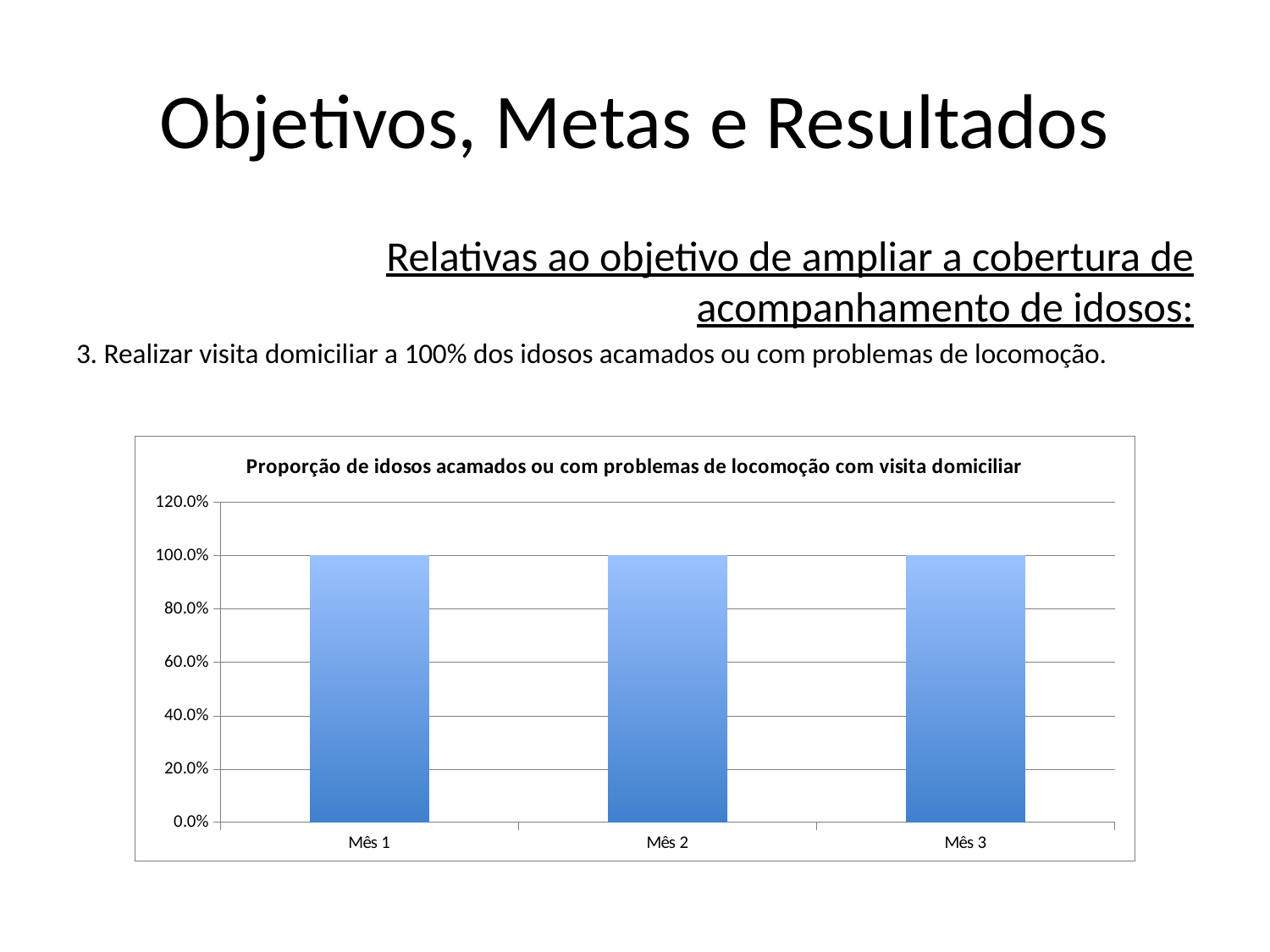
How many categories (months) are shown on the x axis of the chart? 3 What is the value for Mês 2 in the chart? 100.0% What is the title of the chart? Proporção de idosos acamados ou com problemas de locomoção com visita domiciliar Is the value for Mês 3 greater or less than 120.0%? less Is the value for Mês 2 greater or less than 60.0%? greater What is the value for Mês 1 in the chart? 100.0% What is the highest value shown on the y axis of the chart? 120.0% What is the value for Mês 3 in the chart? 100.0% Do the values rise, fall, or stay flat from Mês 1 to Mês 3? stay flat What is the difference between the values for Mês 1 and Mês 3? 0.0% Is the value for Mês 1 greater or less than 80.0%? greater What kind of chart is shown on the slide? bar chart